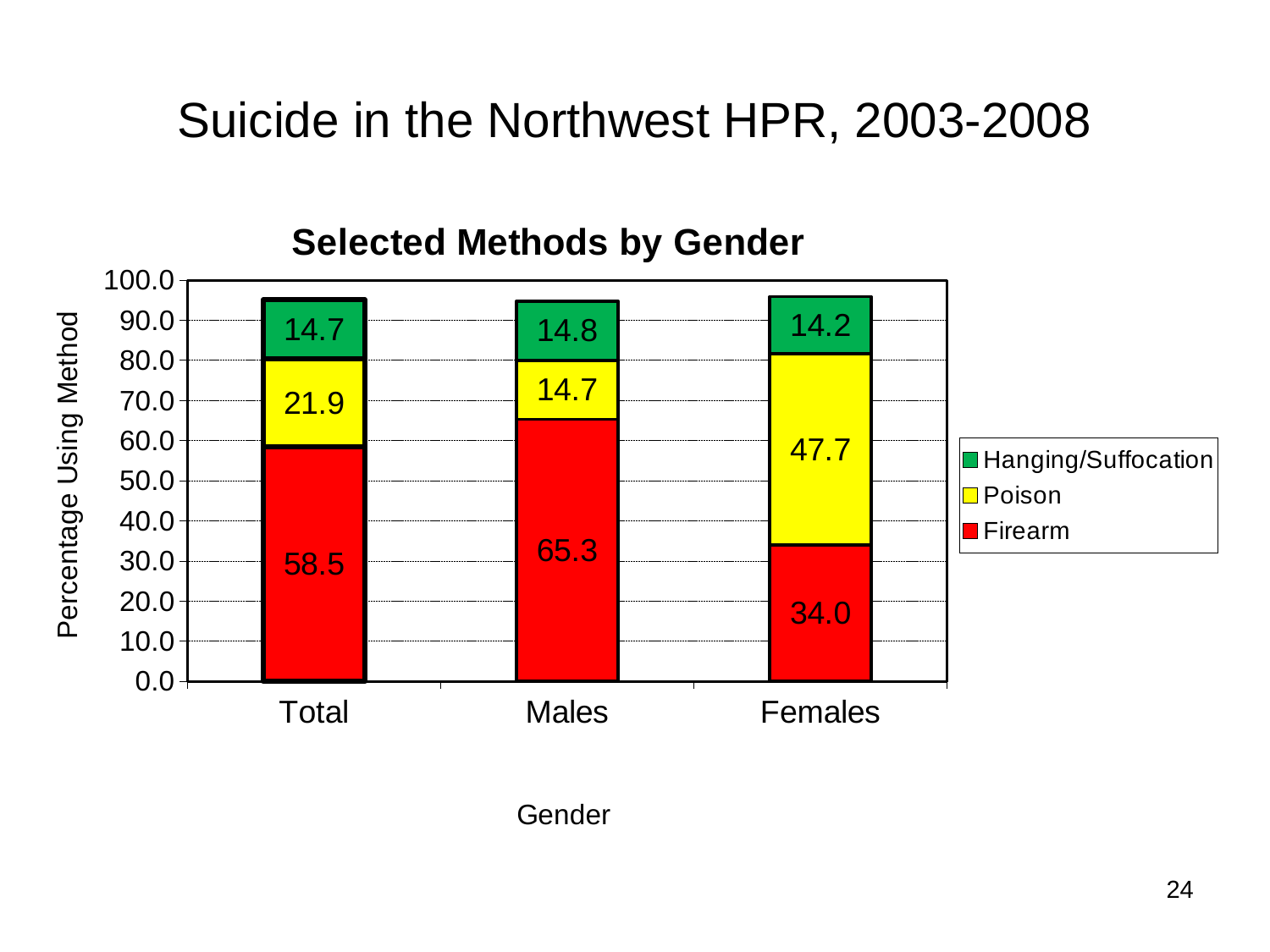
What is the Hanging/Suffocation value for Total? 14.7 What type of chart is shown on the slide? Stacked bar chart How many categories are shown on the x axis? 3 How many series does the legend list? 3 What is the total of the stacked bar for Females? 95.9 Which gender category has the highest Firearm value? Males What is the Firearm value for Males? 65.3 What is the Firearm value for Females? 34.0 Which gender category has the lowest Poison value? Males What is the Poison value for Females? 47.7 What is the difference between the Firearm values for Males and Females? 31.3 Which is larger, the Poison value for Females or the Poison value for Total? Poison value for Females